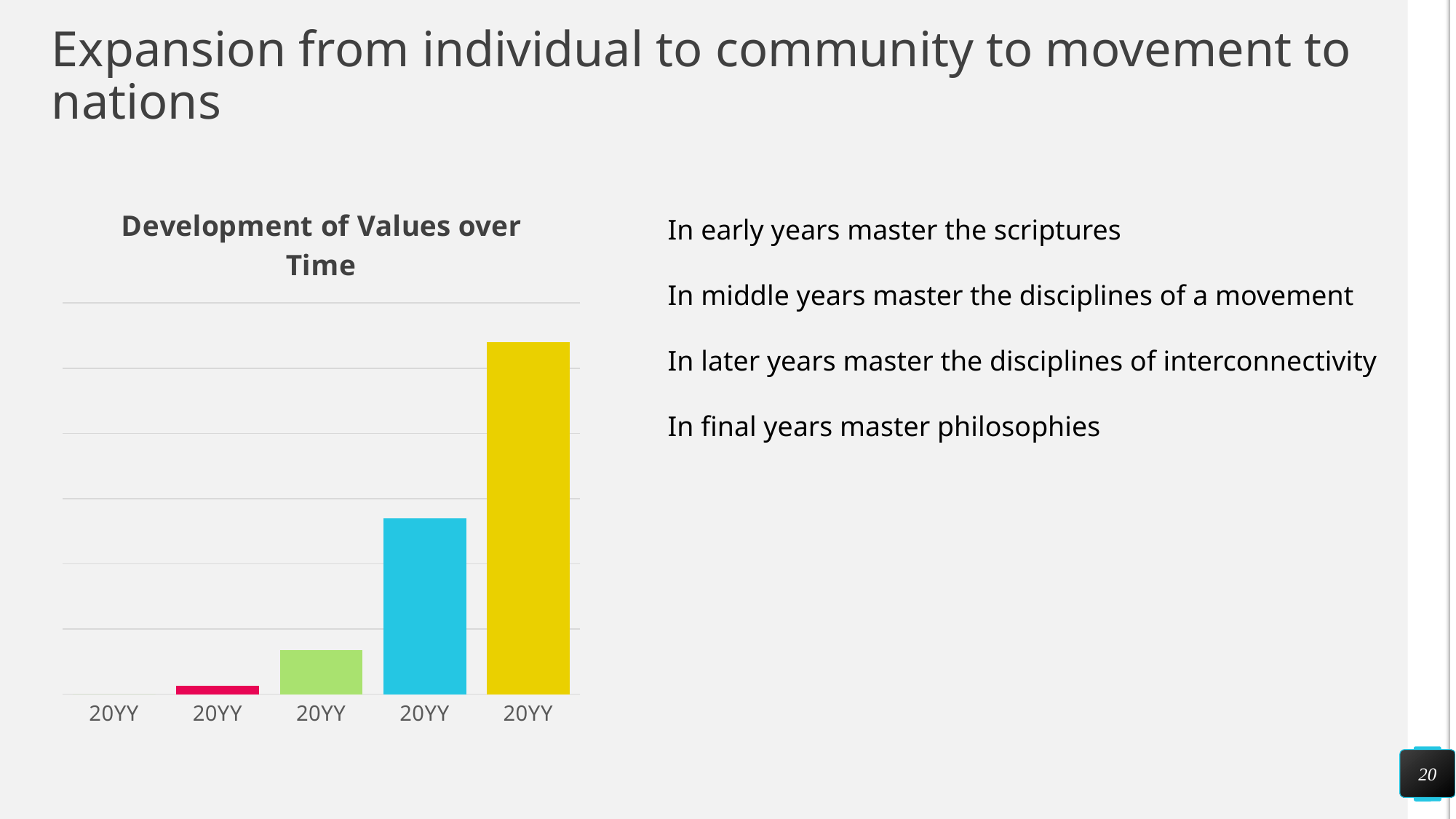
What is the title of the chart? Development of Values over Time Which of the visible bars is the shortest? the pink bar (second category) Which is larger, the blue bar or the green bar? the blue bar What kind of chart is shown on the slide? bar chart Which bar is the tallest in the chart? the rightmost (fifth) bar Which is larger, the green bar or the pink bar? the green bar What label is used for every category on the x axis? 20YY Which is larger, the yellow bar or the blue bar? the yellow bar How many categories are labelled on the x axis of the chart? 5 What colour is the tallest bar in the chart? yellow Do the bar values rise or fall from left to right along the x axis? rise